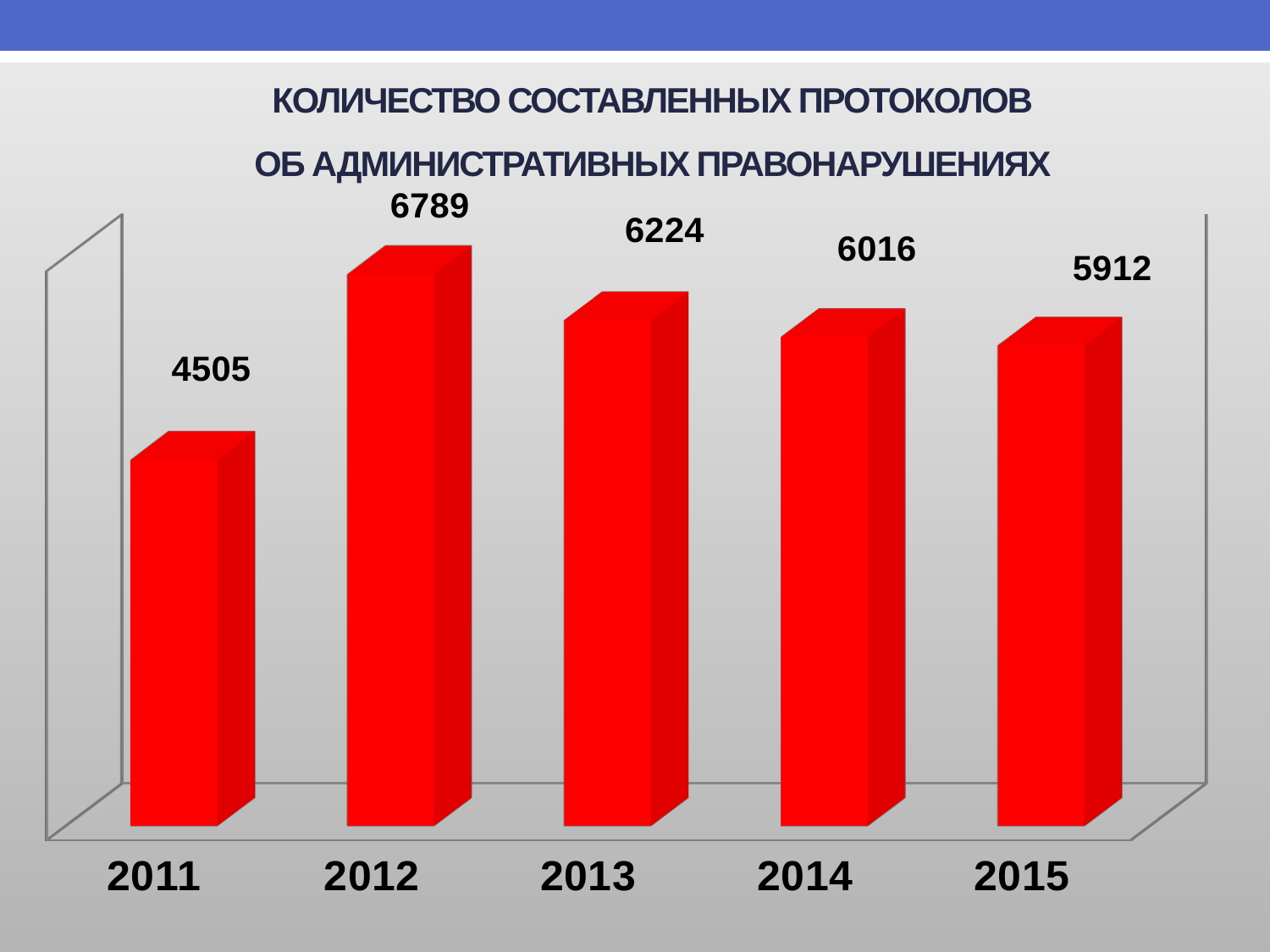
What kind of chart is shown on the slide? bar chart Which is larger, the value for 2013 or the value for 2015? 2013 What is the value for 2015? 5912 How many years are shown on the chart? 5 Which year has the lowest value? 2011 What is the difference between the values for 2012 and 2011? 2284 What is the value for 2011? 4505 What is the difference between the values for 2013 and 2014? 208 What is the value for 2012? 6789 Which year has the highest value? 2012 Do the values rise or fall from 2012 to 2015? fall What colour are the bars in the chart? red